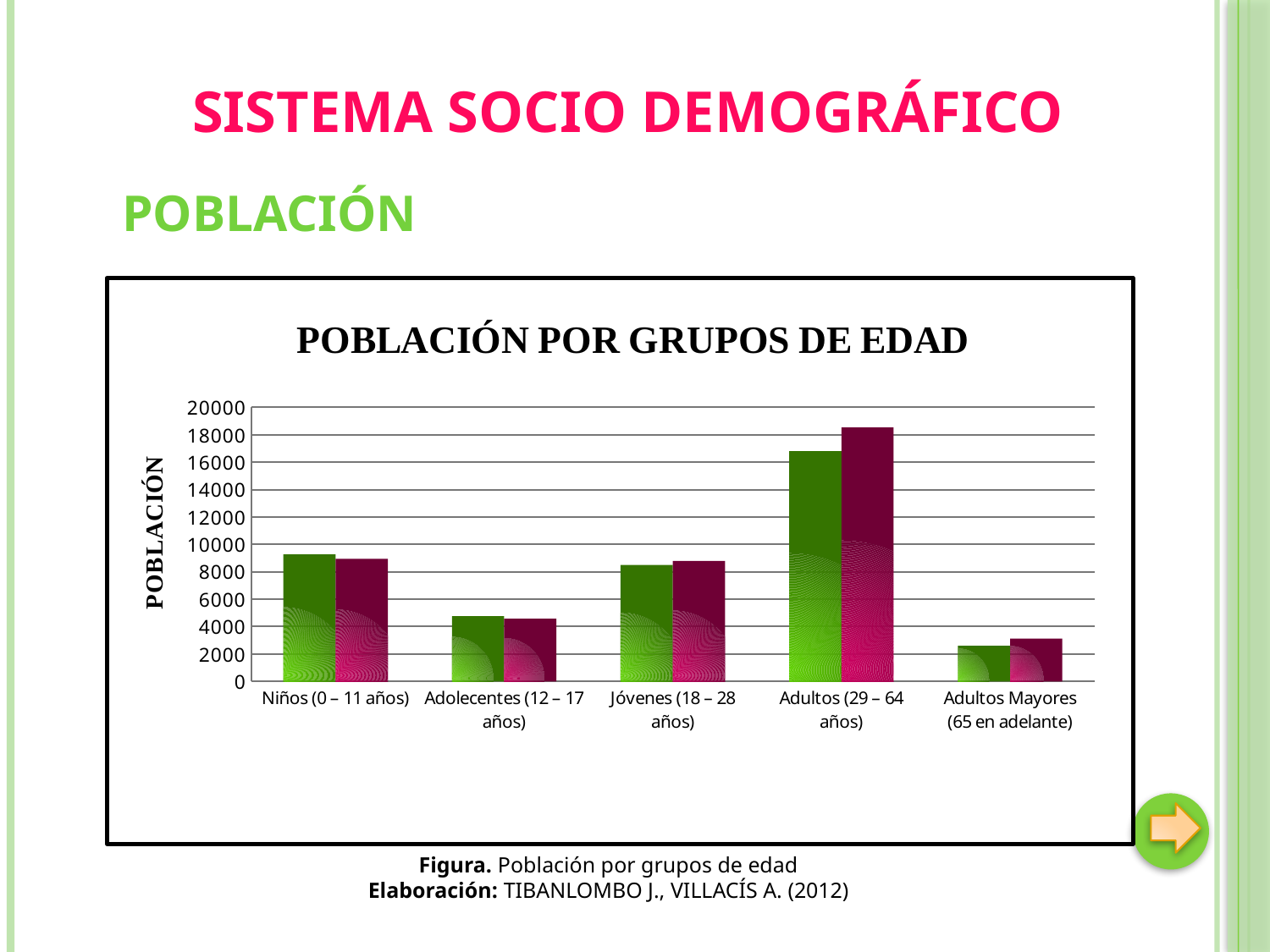
How many age-group categories are shown on the x axis? 5 Is the value of the magenta bar for Adultos (29 – 64 años) greater or less than 18000? greater Is the value of the green bar for Niños (0 – 11 años) greater or less than 8000? greater Which has larger bars, Adultos (29 – 64 años) or Niños (0 – 11 años)? Adultos (29 – 64 años) What kind of chart is shown on the slide? bar chart Is the value of the green bar for Adultos Mayores (65 en adelante) greater or less than 4000? less Which age group has the highest population bars? Adultos (29 – 64 años) Which age group has the lowest population bars? Adultos Mayores (65 en adelante) What is the label on the vertical axis of the chart? POBLACIÓN What is the title of the chart? POBLACIÓN POR GRUPOS DE EDAD Which has larger bars, Adolecentes (12 – 17 años) or Adultos Mayores (65 en adelante)? Adolecentes (12 – 17 años)